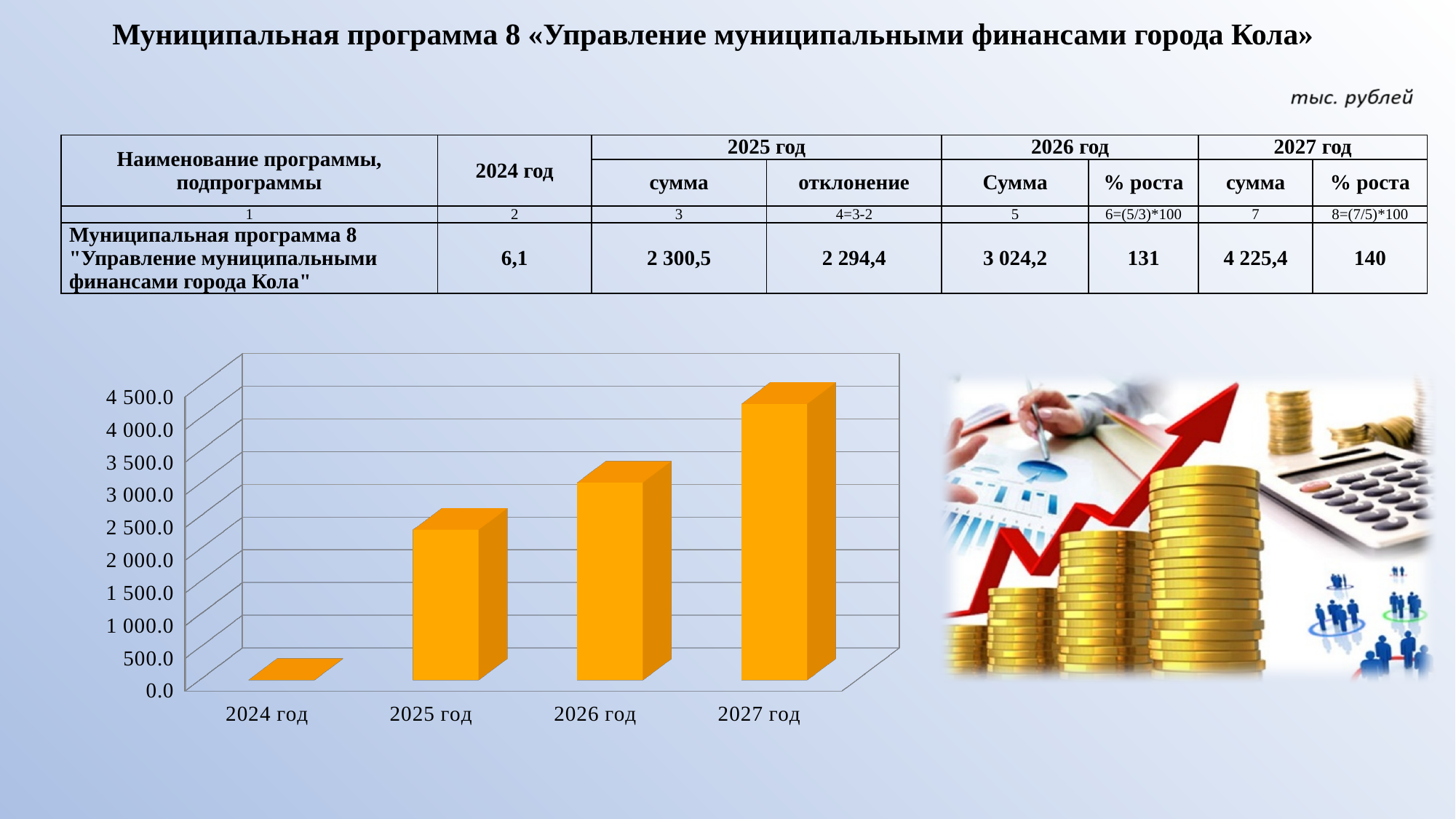
Which is larger, the bar for 2026 год or the bar for 2025 год? 2026 год Is the value for 2027 год greater or less than 4 000.0? greater What colour are the bars in the chart? orange What kind of chart is shown on the slide? bar chart Is the value for 2025 год greater or less than 2 500.0? less Do the bar values rise or fall from 2024 год to 2027 год? rise Is the value for 2026 год greater or less than 3 500.0? less Which year has the highest bar in the chart? 2027 год How many categories (years) are shown on the x axis of the bar chart? 4 Which year has the lowest bar in the chart? 2024 год